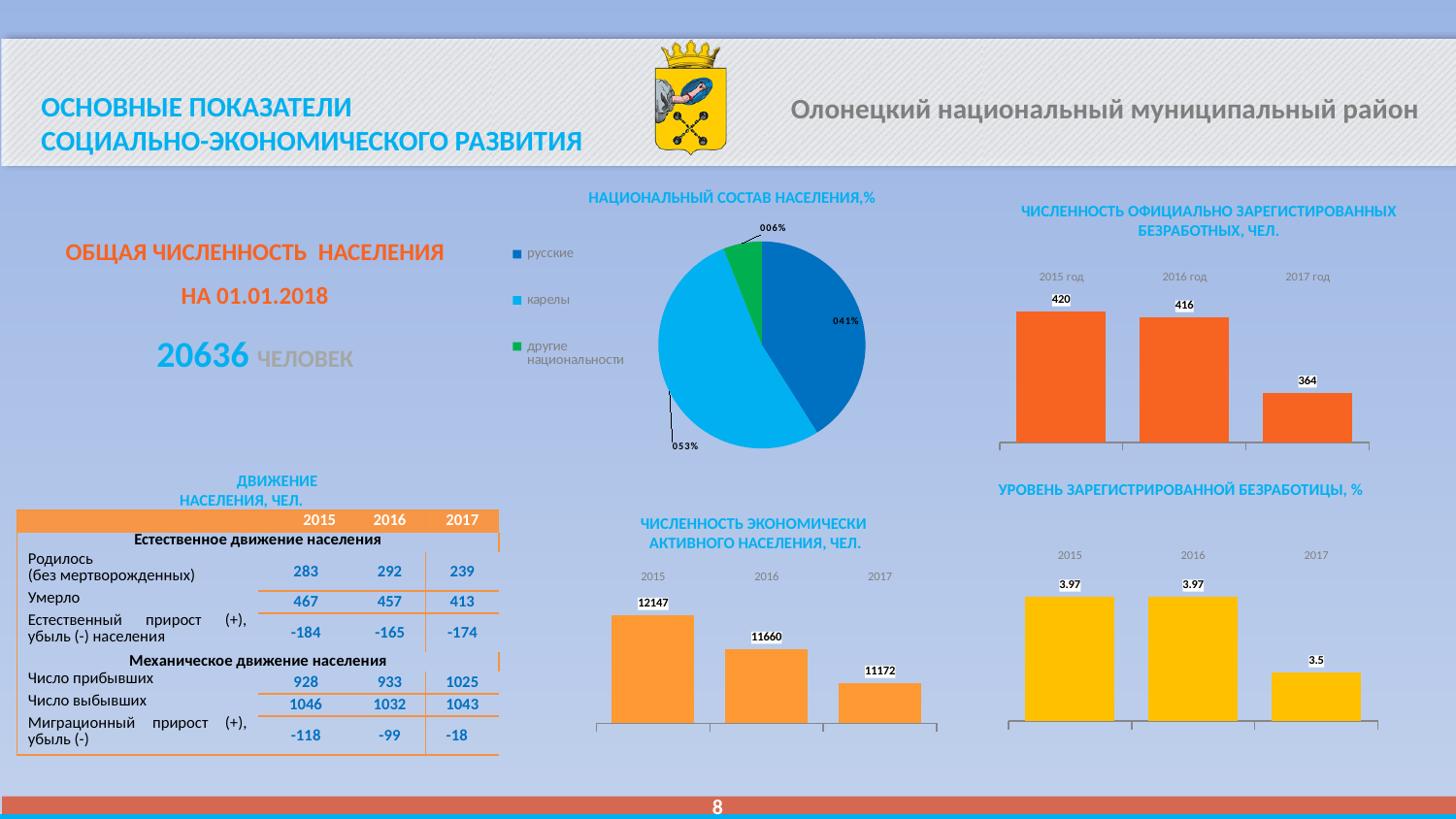
In the chart 'ЧИСЛЕННОСТЬ ЭКОНОМИЧЕСКИ АКТИВНОГО НАСЕЛЕНИЯ, ЧЕЛ.', what is the value for 2016? 11660 How many entries does the legend of the chart 'НАЦИОНАЛЬНЫЙ СОСТАВ НАСЕЛЕНИЯ,%' list? 3 In the chart 'УРОВЕНЬ ЗАРЕГИСТРИРОВАННОЙ БЕЗРАБОТИЦЫ, %', what is the value for 2017? 3.5 In the chart 'ЧИСЛЕННОСТЬ ОФИЦИАЛЬНО ЗАРЕГИСТРИРОВАННЫХ БЕЗРАБОТНЫХ, ЧЕЛ.', what is the difference between the 2015 год and 2017 год values? 56 How many bars are shown in the chart 'УРОВЕНЬ ЗАРЕГИСТРИРОВАННОЙ БЕЗРАБОТИЦЫ, %'? 3 In the chart 'ЧИСЛЕННОСТЬ ЭКОНОМИЧЕСКИ АКТИВНОГО НАСЕЛЕНИЯ, ЧЕЛ.', what is the difference between the 2015 and 2016 values? 487 In the chart 'ЧИСЛЕННОСТЬ ЭКОНОМИЧЕСКИ АКТИВНОГО НАСЕЛЕНИЯ, ЧЕЛ.', which year has the lowest value? 2017 In the chart 'УРОВЕНЬ ЗАРЕГИСТРИРОВАННОЙ БЕЗРАБОТИЦЫ, %', is the value for 2015 larger or smaller than the value for 2017? larger In the chart 'ЧИСЛЕННОСТЬ ОФИЦИАЛЬНО ЗАРЕГИСТРИРОВАННЫХ БЕЗРАБОТНЫХ, ЧЕЛ.', what is the value for 2017 год? 364 In the chart 'ЧИСЛЕННОСТЬ ЭКОНОМИЧЕСКИ АКТИВНОГО НАСЕЛЕНИЯ, ЧЕЛ.', do the values rise or fall from 2015 to 2017? fall In the chart 'ЧИСЛЕННОСТЬ ОФИЦИАЛЬНО ЗАРЕГИСТРИРОВАННЫХ БЕЗРАБОТНЫХ, ЧЕЛ.', which year has the highest value? 2015 год What kind of chart is 'НАЦИОНАЛЬНЫЙ СОСТАВ НАСЕЛЕНИЯ,%'? pie chart